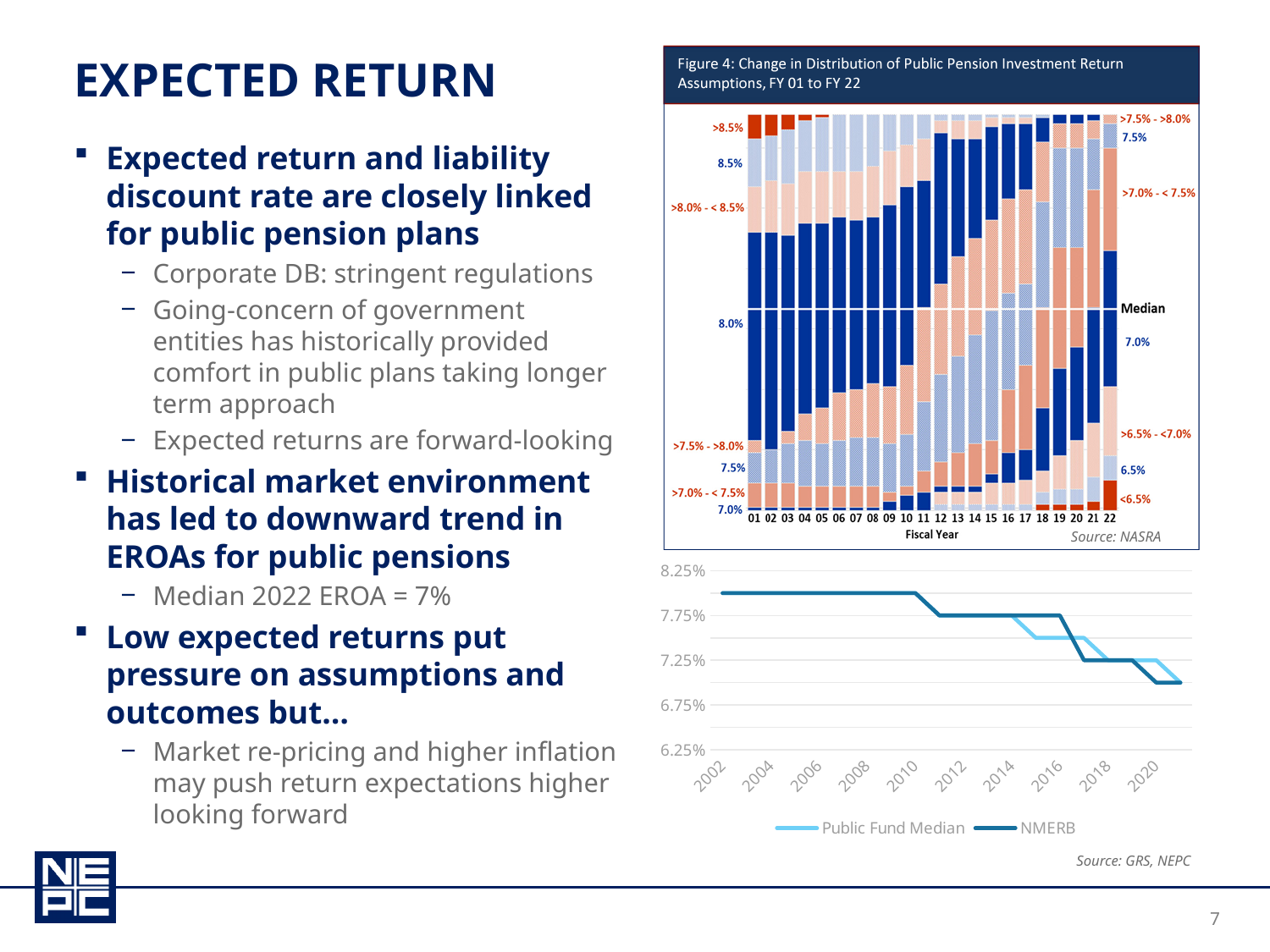
In the bottom line chart, is the value for NMERB in 2020 greater or less than 7.25%? less In the bottom line chart, is the value for Public Fund Median in 2002 greater or less than 7.75%? greater What kind of chart is the bottom chart on the slide? line chart What kind of chart is the Figure 4 chart at the top right of the slide? bar chart How many fiscal years are shown along the x axis of the Figure 4 bar chart? 22 In the bottom line chart, which series has the higher value in 2016, Public Fund Median or NMERB? NMERB What is the x-axis label of the Figure 4 bar chart? Fiscal Year What are the two series named in the legend of the bottom line chart? Public Fund Median and NMERB In the bottom line chart, is the value for NMERB in 2004 greater or less than 8.25%? less How many series does the legend of the bottom line chart list? 2 What is the title of the bar chart at the top right of the slide? Figure 4: Change in Distribution of Public Pension Investment Return Assumptions, FY 01 to FY 22 In the bottom line chart, do the values for NMERB rise or fall from 2002 to 2020? fall